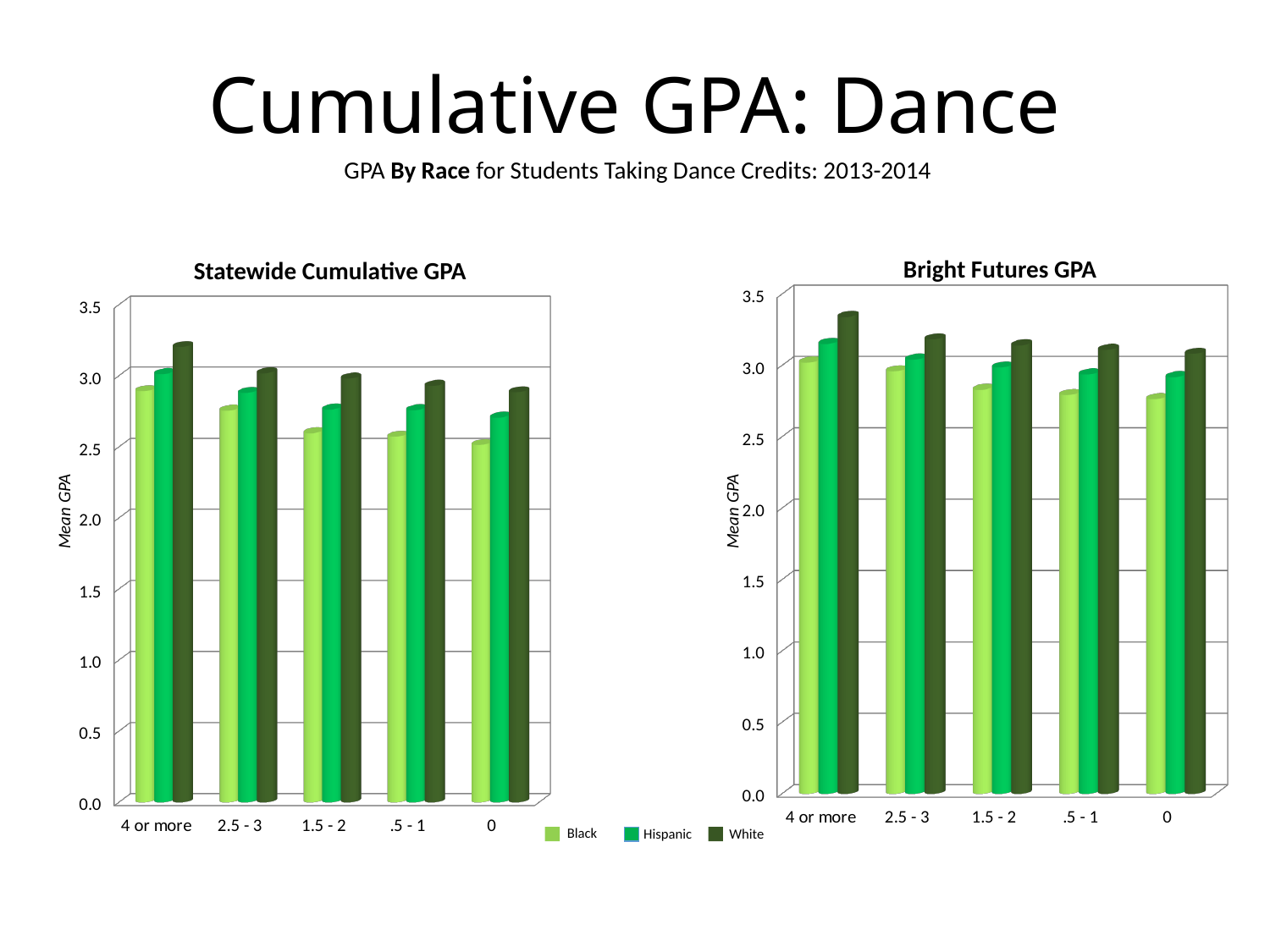
In the Bright Futures GPA chart, do the values for Black students rise or fall moving from '4 or more' to '0' along the x axis? fall What kind of chart is the Statewide Cumulative GPA chart? bar chart In the Statewide Cumulative GPA chart, which is larger for the '2.5 - 3' category: the Black value or the White value? White What is the label on the vertical axis of the Statewide Cumulative GPA chart? Mean GPA How many categories are shown on the x axis of the Bright Futures GPA chart? 5 How many series does the legend list for the charts on this slide? 3 In the Statewide Cumulative GPA chart, which series has the highest bar in the '4 or more' category? White In the Bright Futures GPA chart, which series has the lowest bar in the '0' category? Black In the Statewide Cumulative GPA chart, is the value for Black students in the '0' category greater or less than 3.0? less In the Bright Futures GPA chart, is the value for Black students in the '0' category greater or less than 3.0? less In the Statewide Cumulative GPA chart, is the value for White students in the '4 or more' category greater or less than 3.0? greater